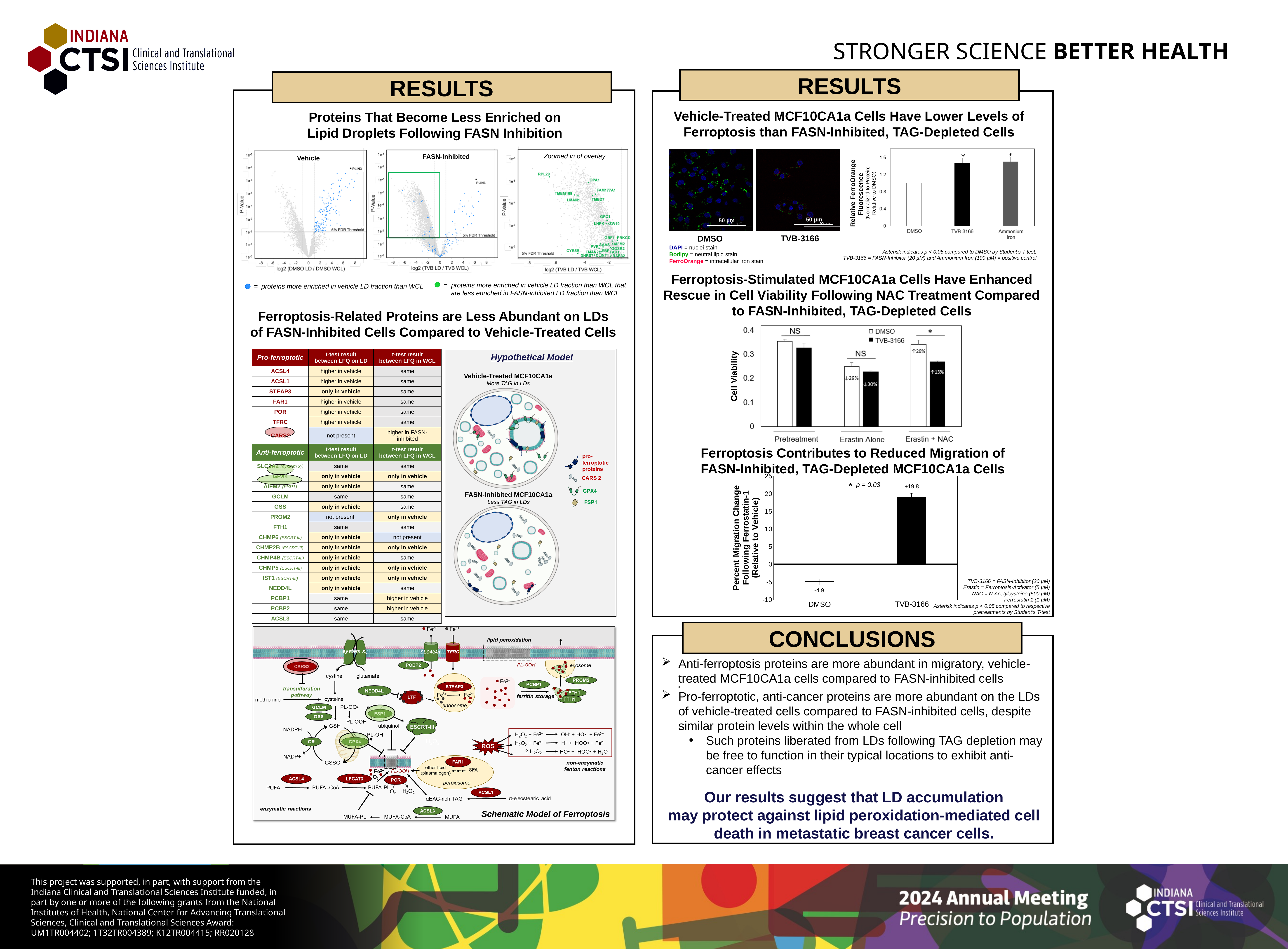
In the 'Relative FerroOrange Fluorescence' chart, is the value for TVB-3166 greater or less than 1.2? greater In the 'Percent Migration Change Following Ferrostatin-1' chart, what is the value for TVB-3166? +19.8 In the 'Cell Viability' chart, what percentage change label is printed on the TVB-3166 bar for Erastin + NAC? ↑13% In the 'Cell Viability' chart, which series has the larger value for Erastin + NAC, DMSO or TVB-3166? DMSO In the 'Percent Migration Change Following Ferrostatin-1' chart, what is the value for DMSO? -4.9 In the 'Cell Viability' chart, is the DMSO value for Erastin Alone greater or less than 0.3? less In the 'Relative FerroOrange Fluorescence' chart, how many categories are shown on the x axis? 3 In the 'Cell Viability' chart, how many series does the legend list? 2 In the 'Relative FerroOrange Fluorescence' chart, which category has the lowest value? DMSO In the 'Percent Migration Change Following Ferrostatin-1' chart, what is the difference between the TVB-3166 and DMSO values? 24.7 What kind of chart is the 'Vehicle' plot under 'Proteins That Become Less Enriched on Lipid Droplets Following FASN Inhibition'? scatter plot In the 'Percent Migration Change Following Ferrostatin-1' chart, what p-value is printed above the bars? p = 0.03